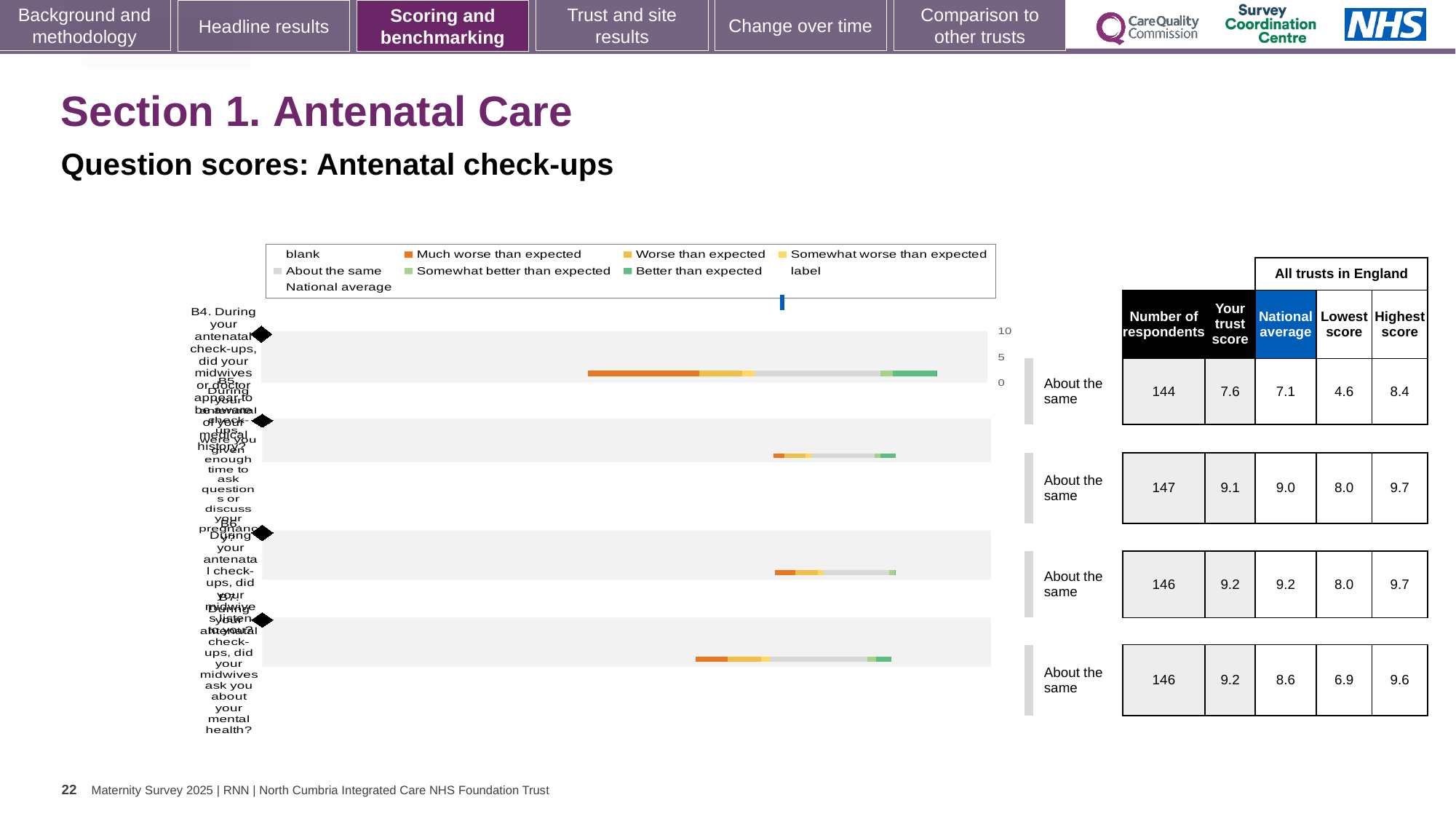
What is the difference between the highest and lowest score for the fourth row (B7)? 2.7 What benchmark category label is shown next to each of the four rows? About the same How many questions (rows) are plotted in the chart? 4 For the fourth row (B7), which is larger: the trust score or the national average? Your trust score Which row has the lowest 'Your trust score'? B4 What is the national average for the fourth row (B7, midwives asked about your mental health)? 8.6 What is the difference between the trust score and the national average for the first row (B4)? 0.5 What is the number of respondents for the second row (B5)? 147 What is the number of respondents for the third row (B6)? 146 What is the 'Your trust score' value for the first row (B4, midwives or doctor aware of your medical history)? 7.6 What is the lowest score among all trusts in England for the first row (B4)? 4.6 What kind of chart is used to show the question scores on this slide? bar chart